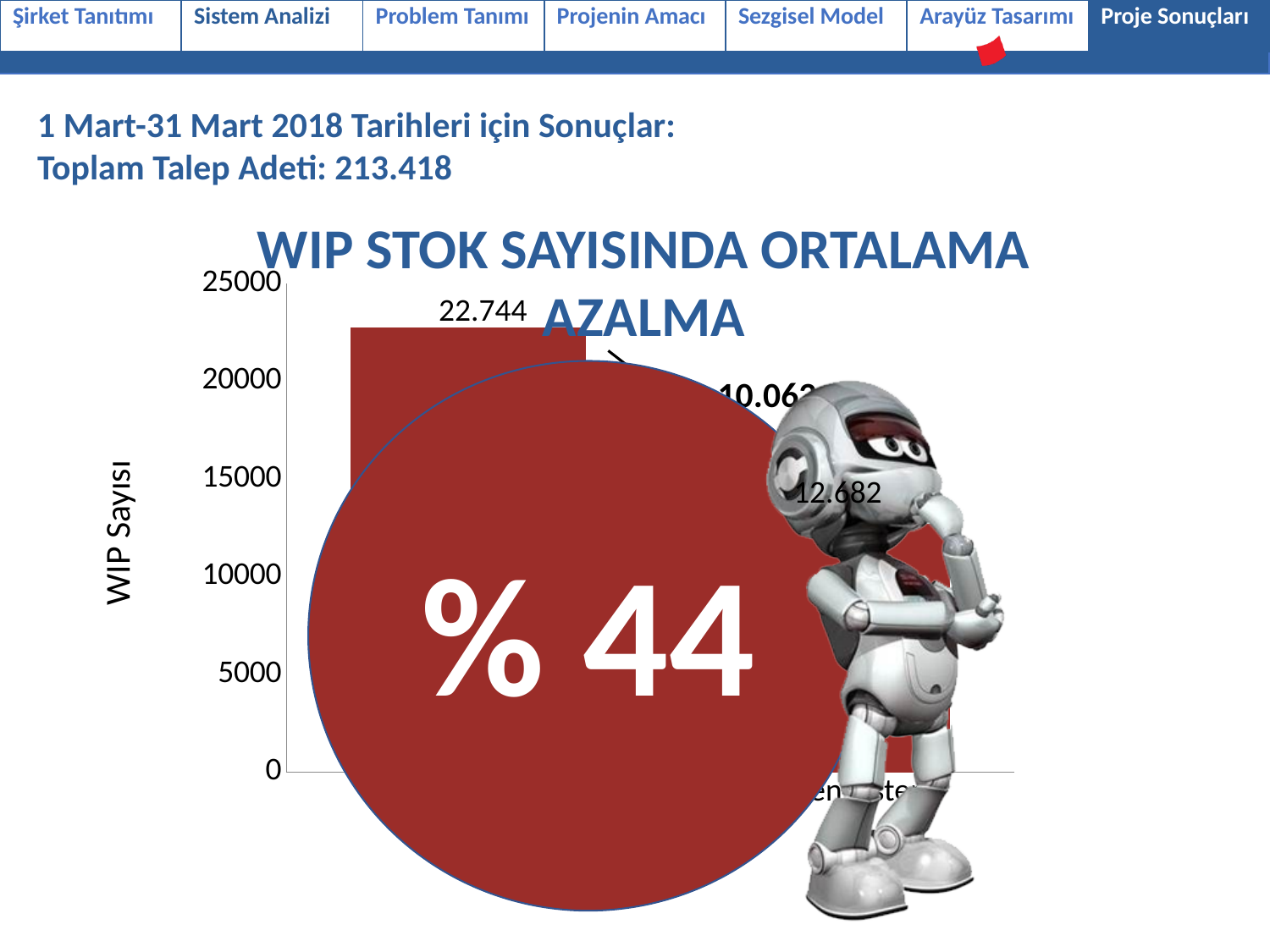
Do the bar values rise or fall from left to right? fall What is the title of the chart? WIP STOK SAYISINDA ORTALAMA AZALMA What value is labelled on the left bar of the chart? 22.744 Which bar is taller, the left bar or the right bar? the left bar Is the value of the right bar greater or less than 15000? less What kind of chart is shown on the slide? bar chart What is the difference between the left bar value (22.744) and the right bar value (12.682)? 10.062 What is the label of the vertical axis of the chart? WIP Sayısı Is the value of the left bar greater or less than 20000? greater What is the highest tick value shown on the vertical axis? 25000 How many bars are plotted in the chart? 2 What value is labelled on the right bar of the chart? 12.682